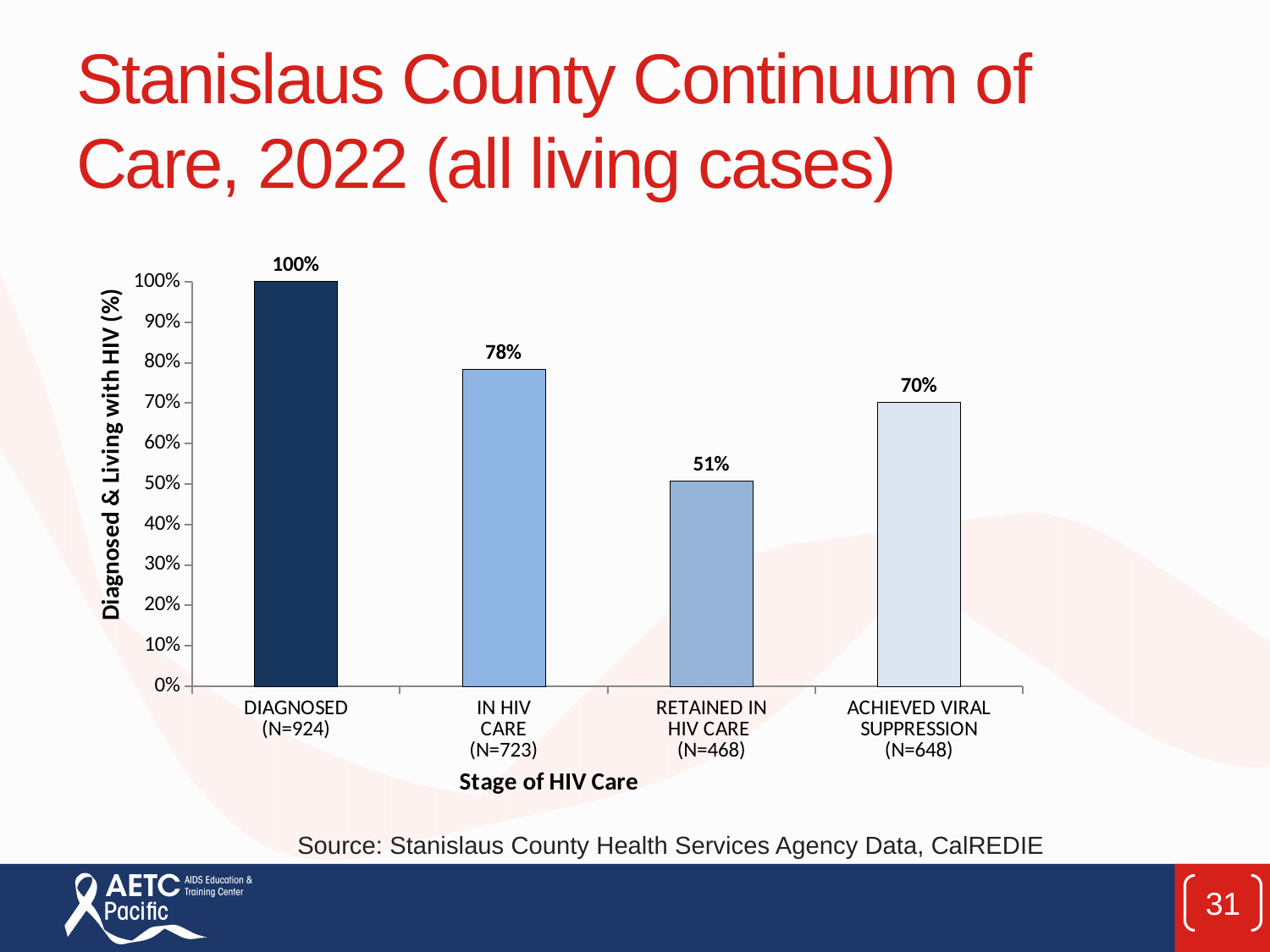
What kind of chart is shown on the slide? Bar chart Which stage of HIV care has the highest percentage? DIAGNOSED Which stage of HIV care has the lowest percentage? RETAINED IN HIV CARE What percentage is shown for the IN HIV CARE stage? 78% Which is larger, the percentage for IN HIV CARE or for ACHIEVED VIRAL SUPPRESSION? IN HIV CARE What is the label of the x axis? Stage of HIV Care What percentage is shown for the ACHIEVED VIRAL SUPPRESSION stage? 70% How many stages of HIV care are shown on the chart? 4 What is the label of the y axis? Diagnosed & Living with HIV (%) What is the difference in percentage points between the IN HIV CARE and RETAINED IN HIV CARE stages? 27 What is the N value shown for the RETAINED IN HIV CARE stage? 468 What percentage is shown for the RETAINED IN HIV CARE stage? 51%